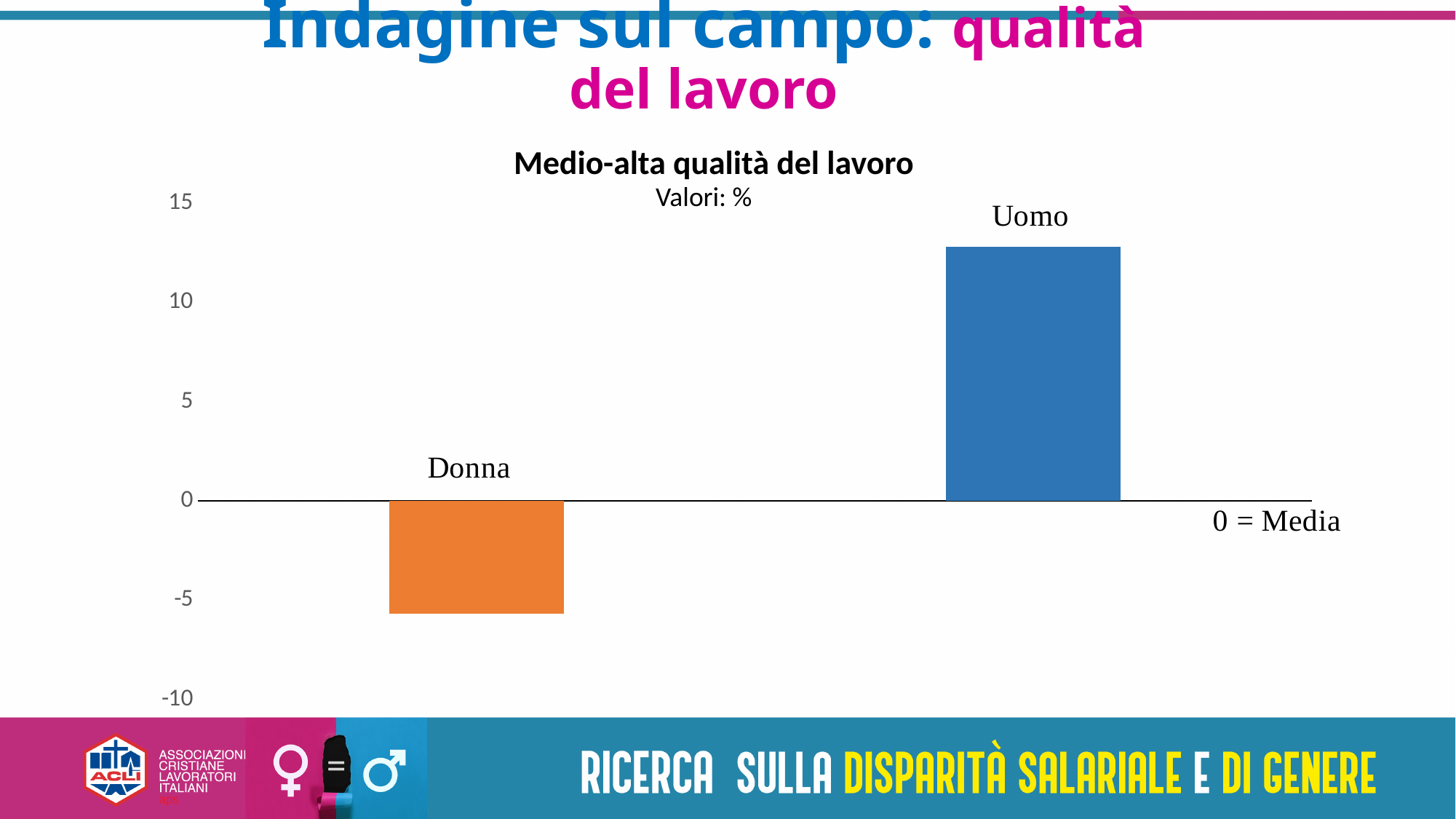
What is the title of the chart? Medio-alta qualità del lavoro Which category has the highest value in the chart? Uomo Is the value for Uomo greater or less than 10? greater Which category has the lowest value in the chart? Donna Is the value for Uomo greater or less than 15? less Which is larger, the value for Uomo or the value for Donna? Uomo What does the annotation next to the horizontal axis say the value 0 represents? Media How many categories (bars) does the chart show? 2 What kind of chart is shown on the slide? Bar chart Is the value for Donna greater or less than -10? greater